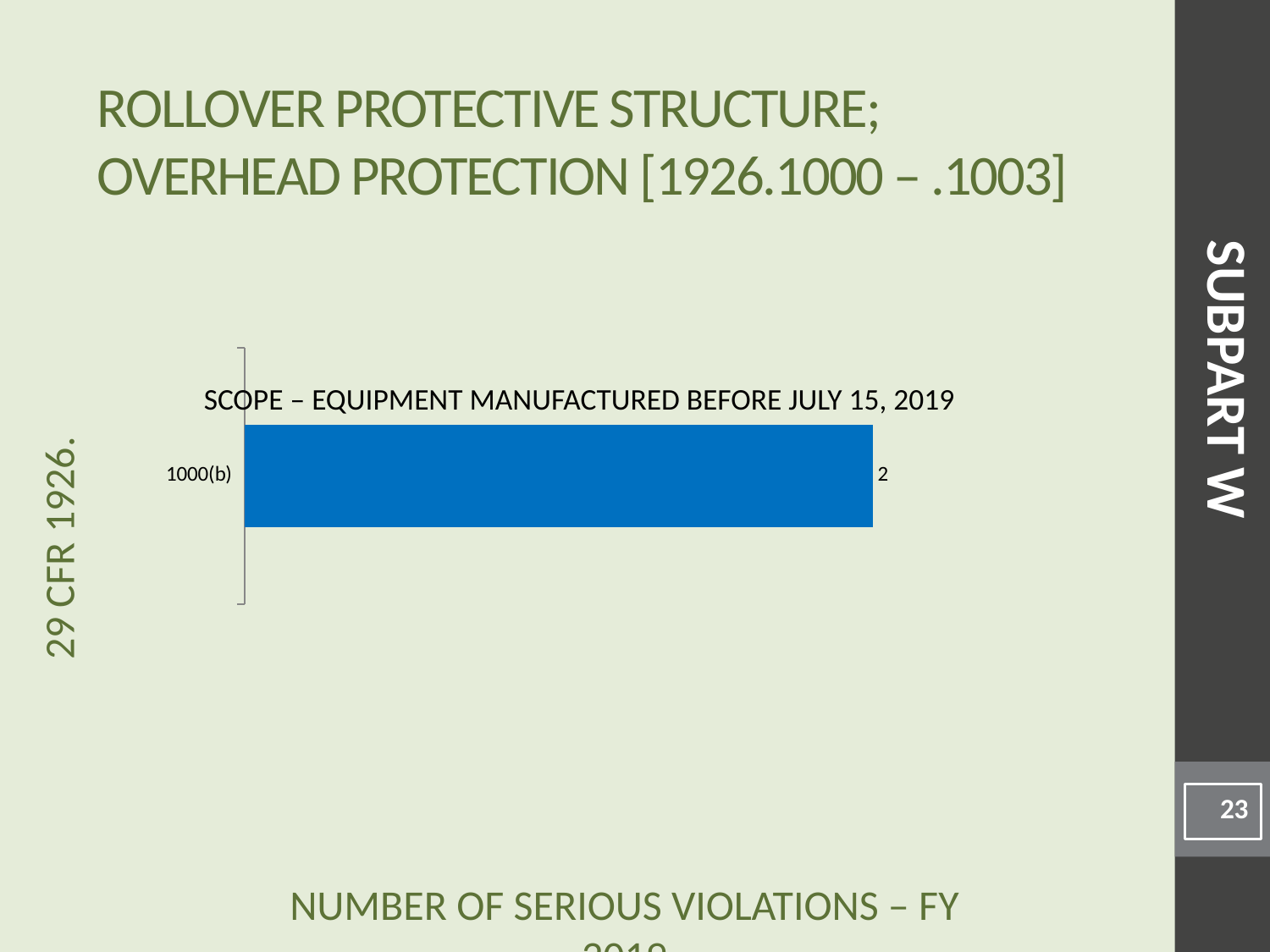
What kind of chart is shown on the slide? bar chart What is the label of the only category in the chart? 1000(b) What is the value for 1000(b)? 2 What is the title of the chart? SCOPE – EQUIPMENT MANUFACTURED BEFORE JULY 15, 2019 How many categories are plotted in the chart? 1 Is the value for 1000(b) greater or less than 1? greater